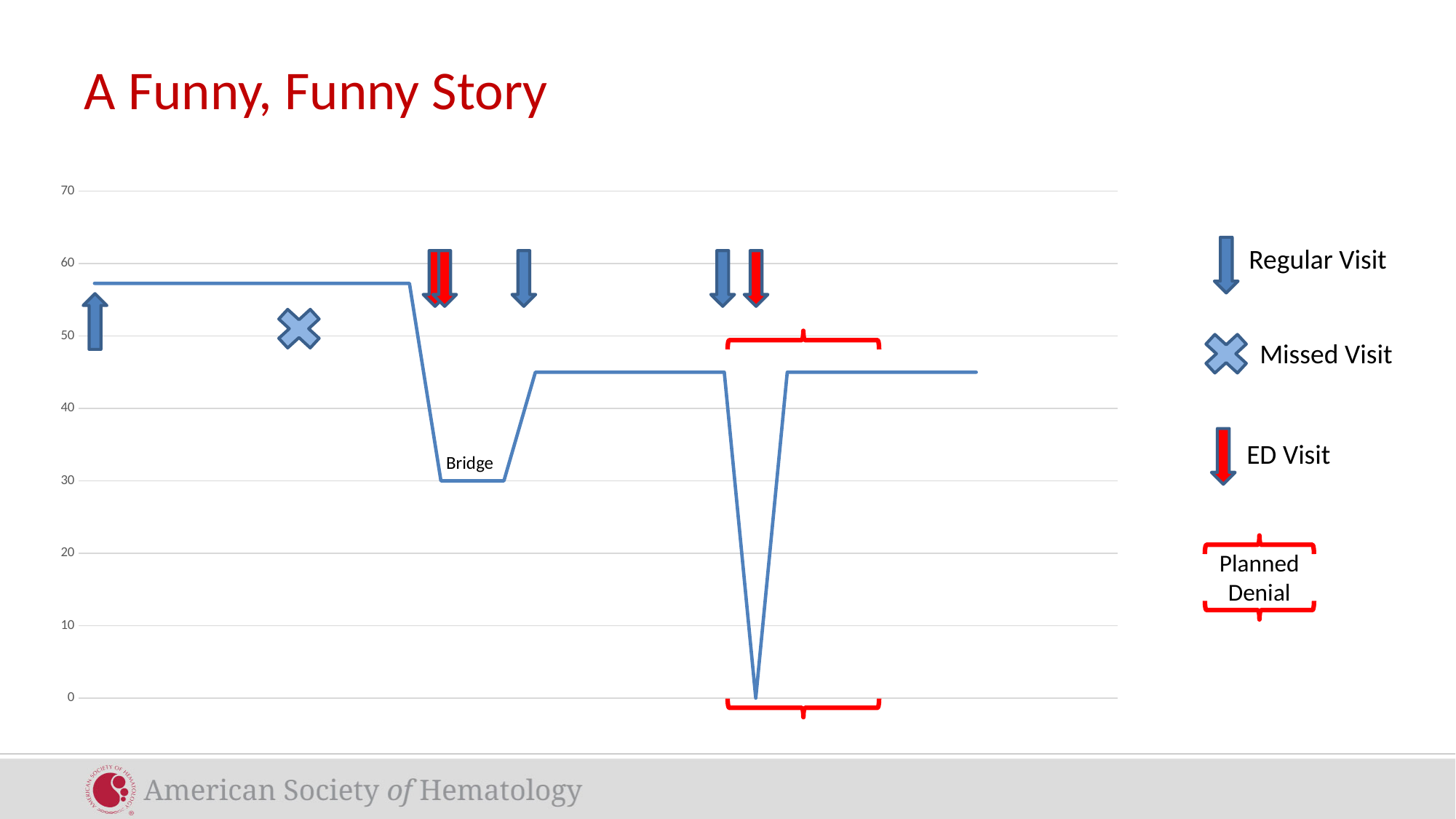
What kind of chart is shown on the slide? line chart Is the value of the line at the start (left end) greater or less than 50? greater How many Missed Visit markers (X symbols) are placed on the chart? 1 Is the value of the line at the end (right end) greater or less than 40? greater Which is larger: the value of the line at the start (left end) or the value at the end (right end)? the start (left end) What is the lowest value the line reaches? 0 What is the highest value shown on the vertical axis? 70 How many red ED Visit arrows are placed above the line? 2 Overall, does the line rise or fall from its left end to its right end? fall Is the value of the line at the start greater or less than 60? less What value does the line reach during the segment labelled "Bridge"? 30 What is the title of the slide containing the chart? A Funny, Funny Story